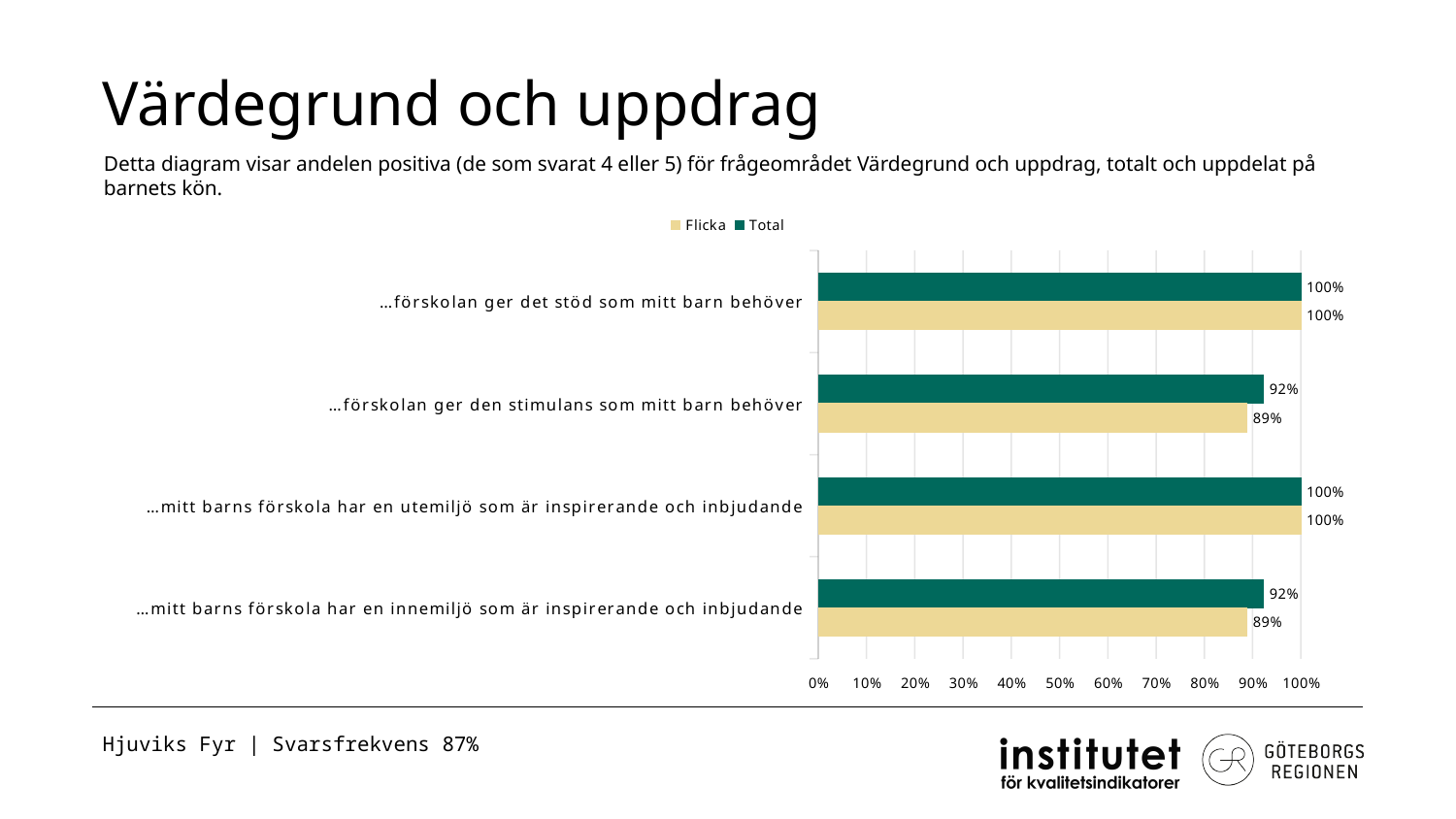
Which series is shown in green in the chart? Total Which category has the lowest Flicka value? …förskolan ger den stimulans som mitt barn behöver and …mitt barns förskola har en innemiljö som är inspirerande och inbjudande (both 89%) What kind of chart is shown on the slide? Bar chart How many series does the legend list? 2 What is the Total value for "…förskolan ger den stimulans som mitt barn behöver"? 92% What is the Total value for "…mitt barns förskola har en utemiljö som är inspirerande och inbjudande"? 100% What is the difference between the Total and Flicka values for "…mitt barns förskola har en innemiljö som är inspirerande och inbjudande"? 3 percentage points What is the Flicka value for "…förskolan ger den stimulans som mitt barn behöver"? 89% What is the Flicka value for "…förskolan ger det stöd som mitt barn behöver"? 100% Which is larger for "…förskolan ger den stimulans som mitt barn behöver": the Total value or the Flicka value? Total How many categories are shown in the chart? 4 What is the Flicka value for "…mitt barns förskola har en innemiljö som är inspirerande och inbjudande"? 89%